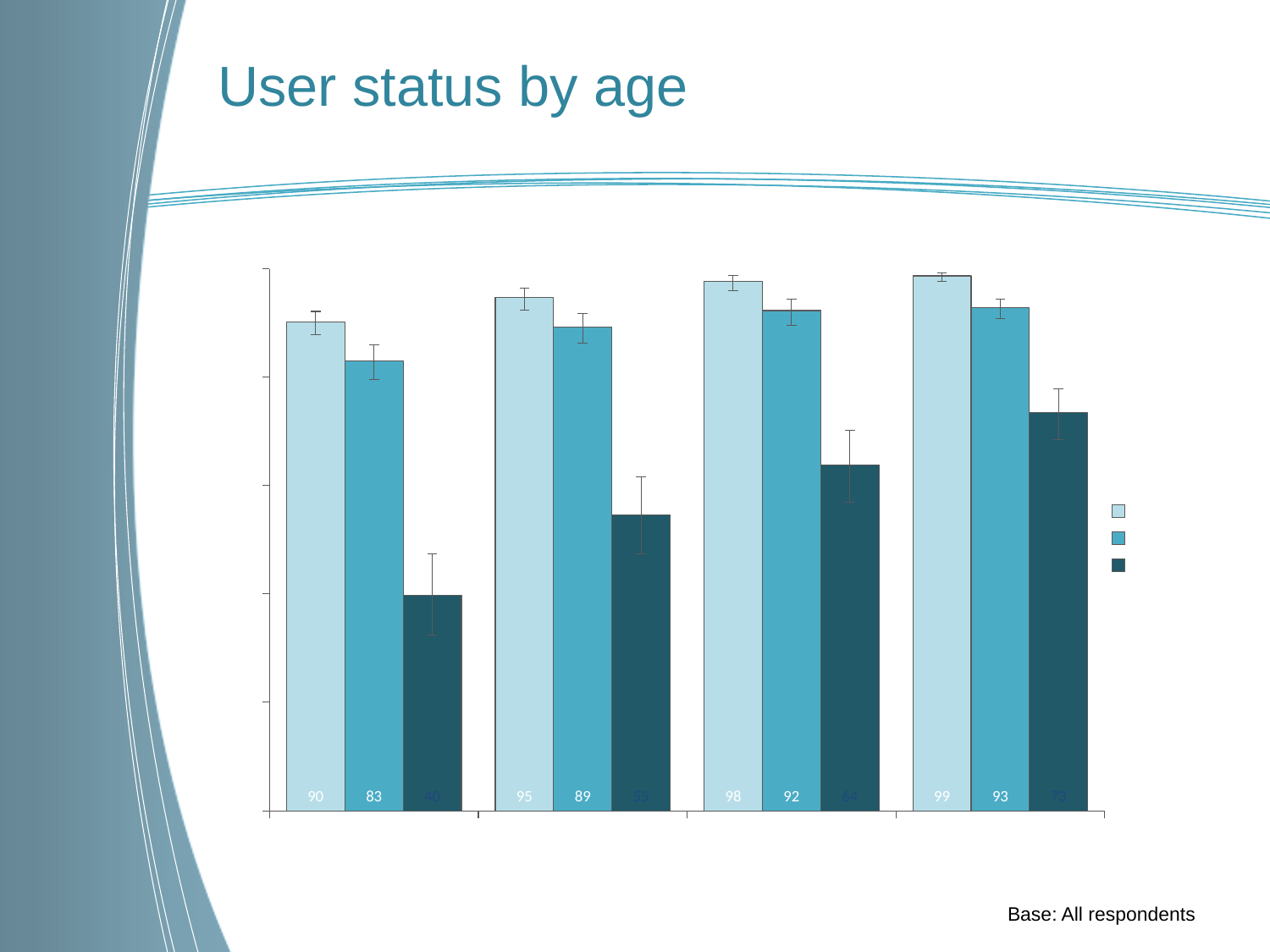
What kind of chart is shown on the slide? Bar chart What is the value of the medium-blue bar in the third group from the left? 92 How many entries does the legend list? 3 In the first (leftmost) group, what is the difference between the lightest bar and the medium-blue bar? 7 What is the value of the medium-blue bar in the second group from the left? 89 What is the value of the lightest bar in the first (leftmost) group? 90 How many groups of bars are plotted along the x axis? 4 Do the values of the lightest bars rise or fall from left to right across the groups? Rise Which group has the lowest value for the medium-blue bar? The first (leftmost) group What is the value of the lightest bar in the fourth (rightmost) group? 99 Which is larger: the lightest bar in the second group or the medium-blue bar in the fourth group? The lightest bar in the second group Which group has the highest value for the lightest bar? The fourth (rightmost) group